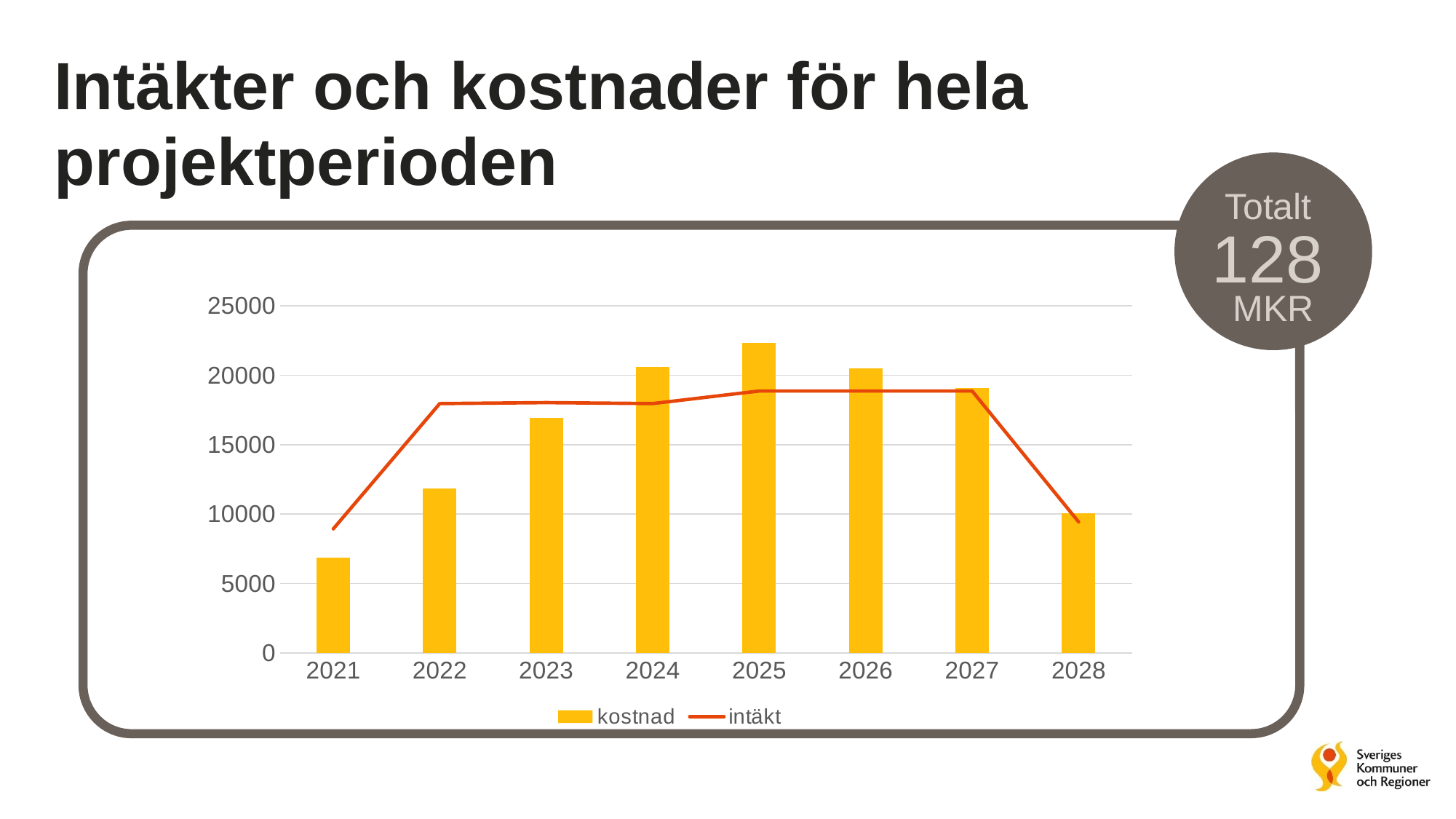
Do the kostnad bars rise or fall from 2021 to 2025? rise What kind of chart is shown on the slide? A bar chart with a line series Which is larger, the kostnad bar for 2024 or the kostnad bar for 2022? 2024 Is the kostnad value for 2021 greater or less than 5000? greater Is the kostnad value for 2023 greater or less than 20000? less Is the intäkt value for 2021 greater or less than 10000? less How many years are shown on the x axis of the chart? 8 Which year has the lowest kostnad bar? 2021 What are the two series named in the legend? kostnad and intäkt How many series does the chart's legend list? 2 Which year has the highest kostnad bar? 2025